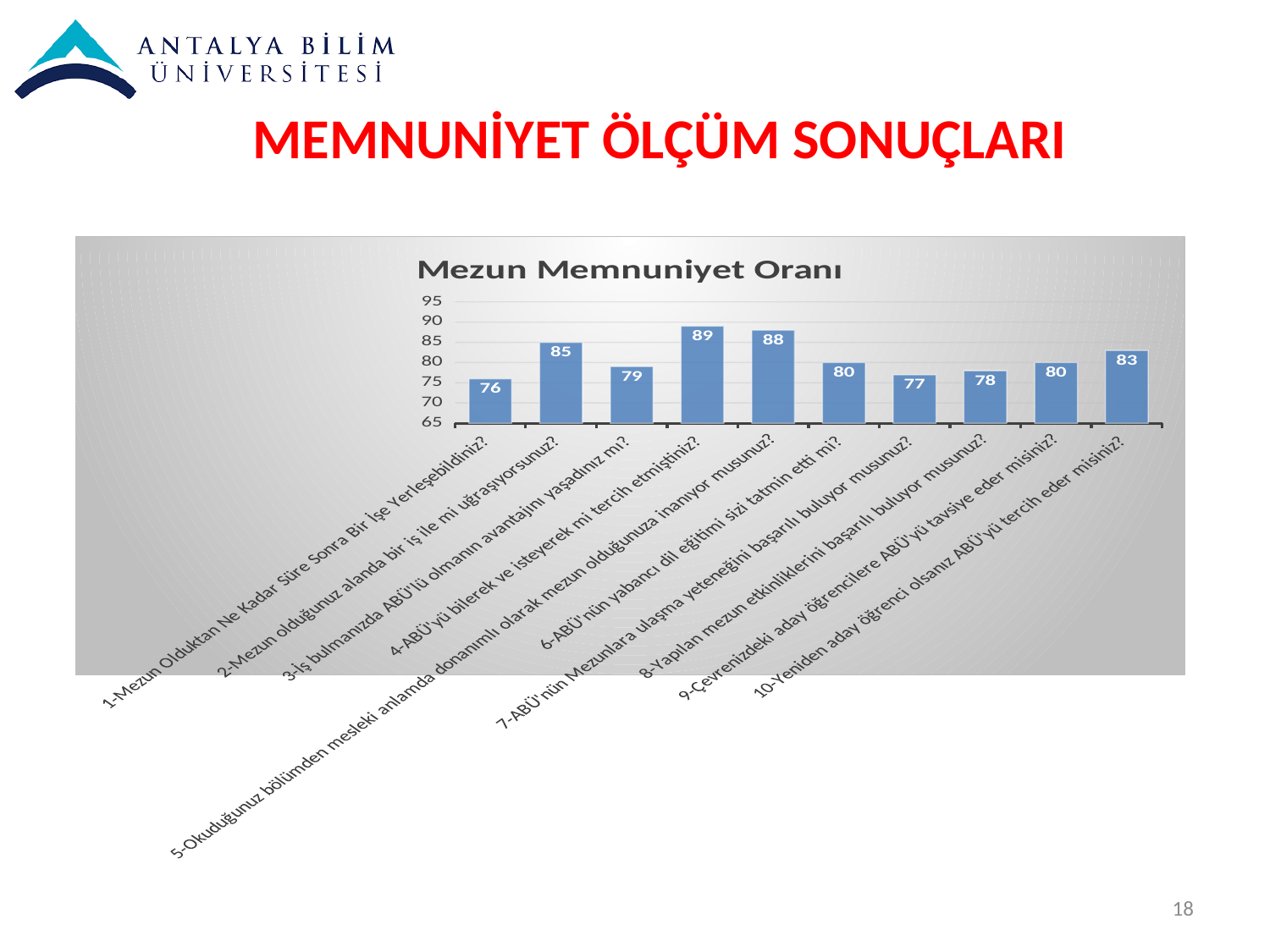
Is the value for question 5 (Okuduğunuz bölümden mesleki anlamda donanımlı olarak mezun olduğunuza inanıyor musunuz?) greater or less than 85? greater What is the value for question 7 (ABÜ'nün Mezunlara ulaşma yeteneğini başarılı buluyor musunuz?)? 77 What is the value for question 4 (ABÜ'yü bilerek ve isteyerek mi tercih etmiştiniz?)? 89 Which question has the lowest value in the chart? 1-Mezun Olduktan Ne Kadar Süre Sonra Bir İşe Yerleşebildiniz? What type of chart is shown on the slide? Bar chart What is the value for question 1 (Mezun Olduktan Ne Kadar Süre Sonra Bir İşe Yerleşebildiniz?)? 76 How many categories (questions) are plotted in the chart? 10 What is the difference between the values for question 4 and question 1? 13 What is the title of the chart? Mezun Memnuniyet Oranı Which question has the highest value in the chart? 4-ABÜ'yü bilerek ve isteyerek mi tercih etmiştiniz? What is the value for question 10 (Yeniden aday öğrenci olsanız ABÜ'yü tercih eder misiniz?)? 83 Which has a larger value: question 2 (Mezun olduğunuz alanda bir iş ile mi uğraşıyorsunuz?) or question 3 (İş bulmanızda ABÜ'lü olmanın avantajını yaşadınız mı?)? Question 2